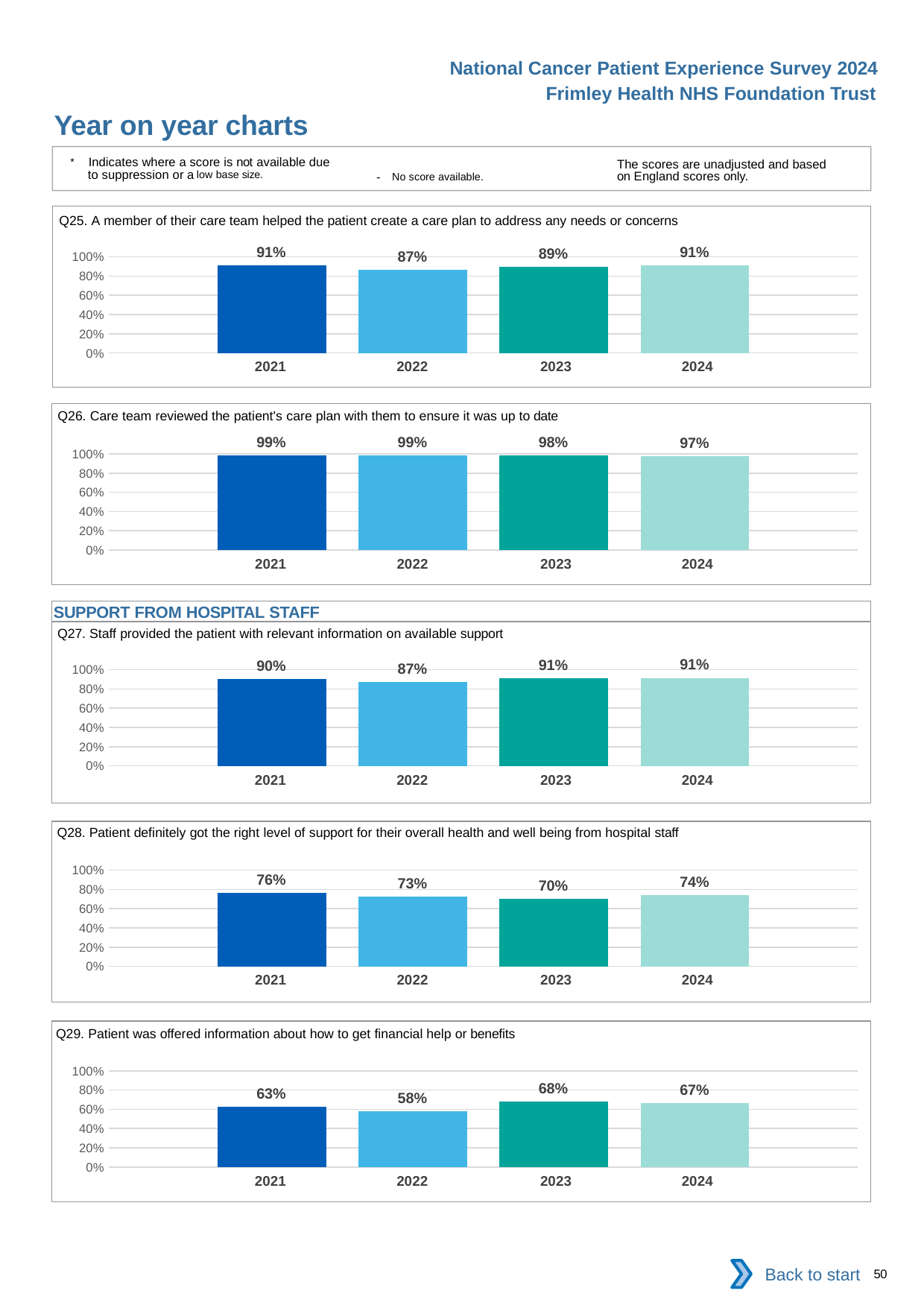
In the Q26 chart, which year has the lowest value? 2024 In the Q25 chart, what is the value for 2022? 87% In the Q28 chart, which year has the highest value? 2021 In the Q29 chart, which is larger, the value for 2021 or the value for 2022? 2021 In the Q28 chart, what is the difference between the 2021 value and the 2023 value? 6% What kind of chart is the Q25 chart? bar chart How many bars are shown in the Q26 chart? 4 In the Q27 chart, what is the difference between the 2023 value and the 2022 value? 4% In the Q26 chart, do the values rise or fall from 2022 to 2024? fall In the Q29 chart, what is the value for 2023? 68% In the Q29 chart, is the value for 2022 greater or less than 60%? less In the Q28 chart, what is the value for 2024? 74%